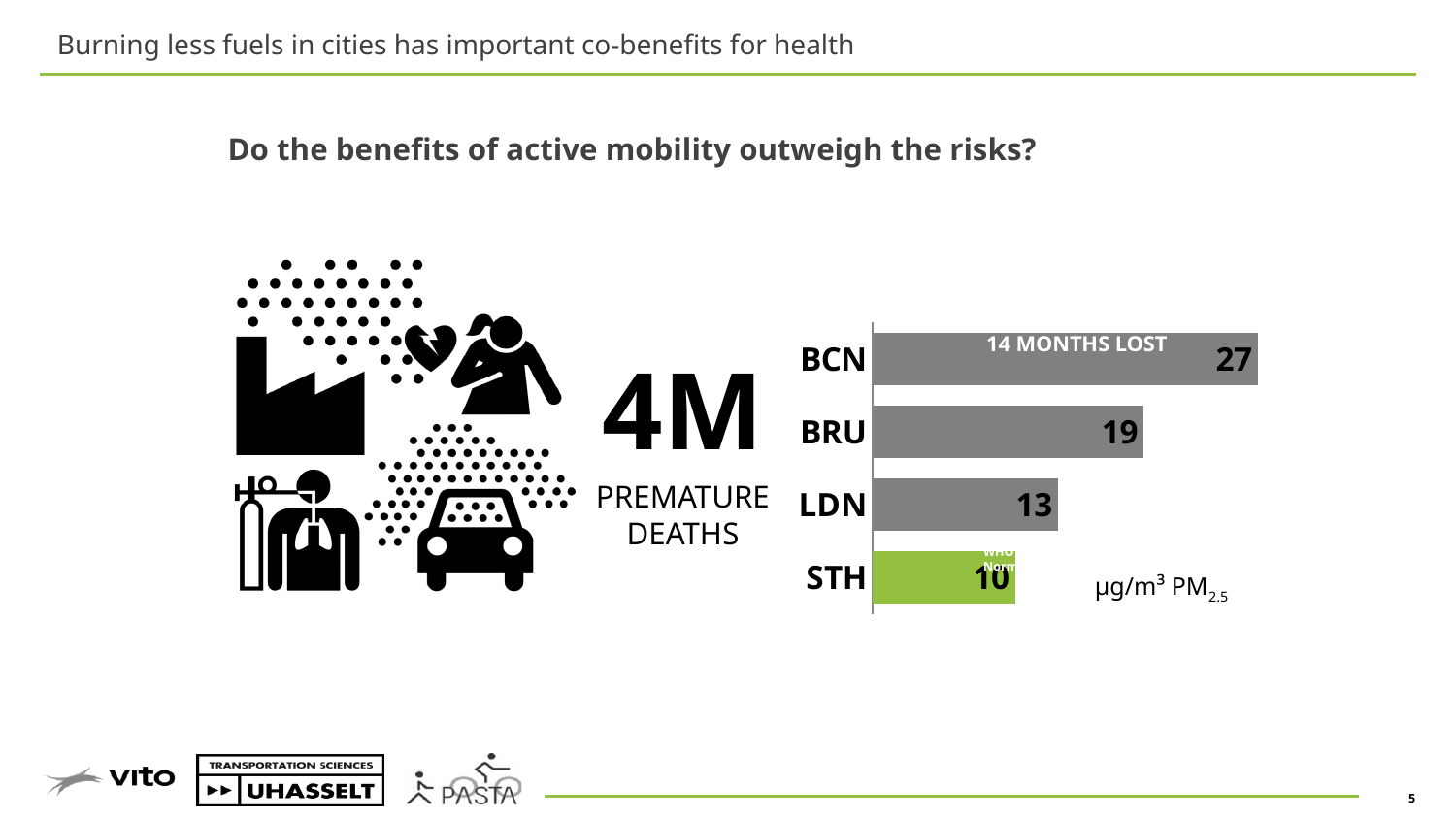
What is the value for STH in the bar chart? 10 What is the difference between the values for BCN and BRU? 8 Which city has the lowest value in the bar chart? STH Which is larger, the value for BRU or the value for LDN? BRU How many cities are shown in the bar chart? 4 What kind of chart is shown on the slide? bar chart What is the value for LDN in the bar chart? 13 Which city's bar is coloured green in the chart? STH What is the difference between the values for LDN and STH? 3 What is the value for BRU in the bar chart? 19 Which city has the highest value in the bar chart? BCN What is the value for BCN in the bar chart? 27